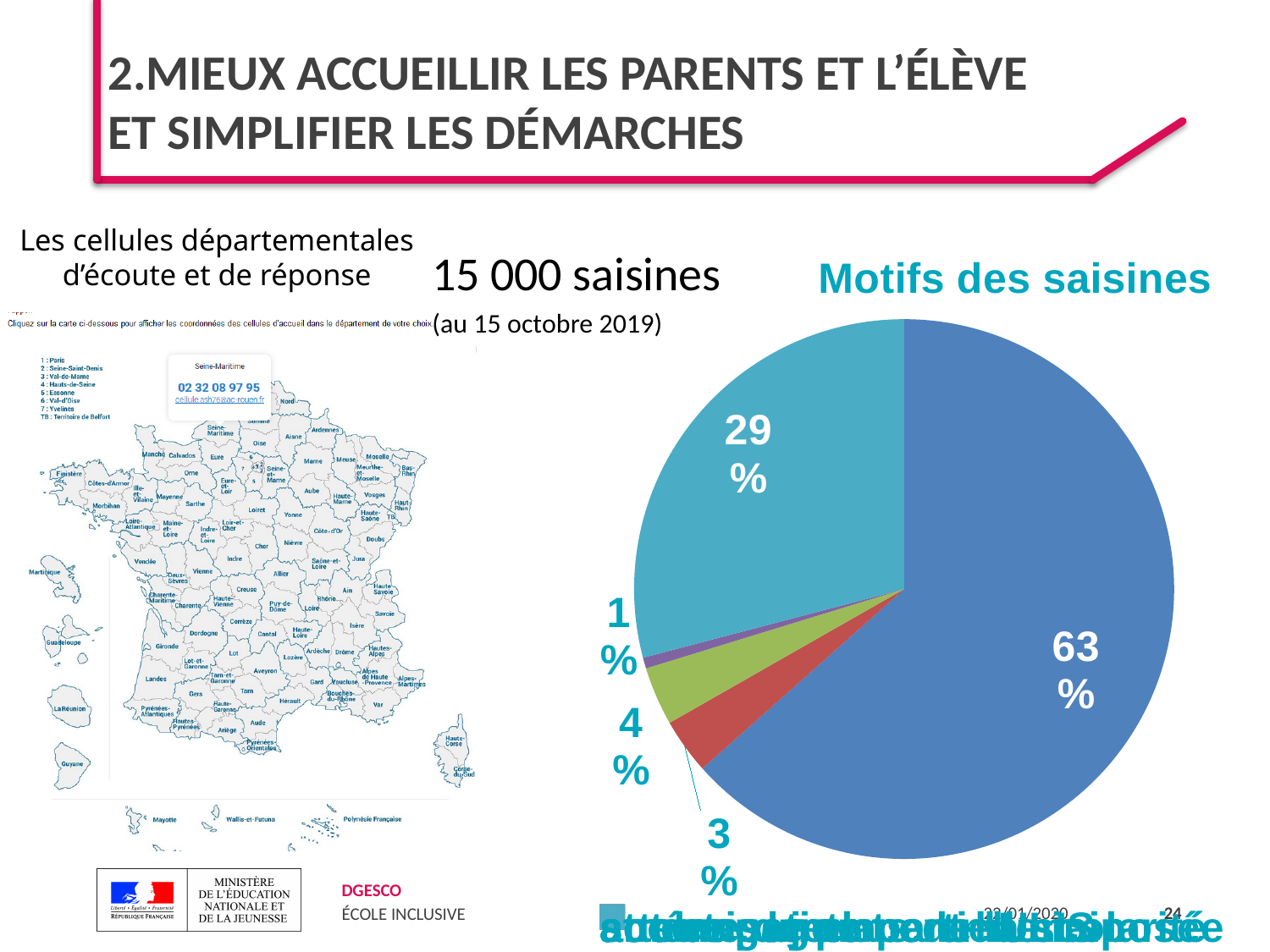
In the pie chart 'Motifs des saisines', what share does the dark blue slice represent? 63% How many slices does the pie chart 'Motifs des saisines' have? 5 In the pie chart 'Motifs des saisines', what is the share of the largest slice? 63% In the pie chart 'Motifs des saisines', which slice is larger, the dark blue one or the teal one? the dark blue one What kind of chart is shown on the right of the slide? pie chart In the pie chart 'Motifs des saisines', what do the two largest slices add up to? 92% What is the title of the pie chart? Motifs des saisines In the pie chart 'Motifs des saisines', what is the share of the smallest slice? 1% In the pie chart 'Motifs des saisines', what share does the teal slice represent? 29% In the pie chart 'Motifs des saisines', what colour is the largest slice? dark blue In the pie chart 'Motifs des saisines', what is the difference between the largest slice and the second largest slice? 34 percentage points In the pie chart 'Motifs des saisines', is the largest slice greater or less than 50%? greater